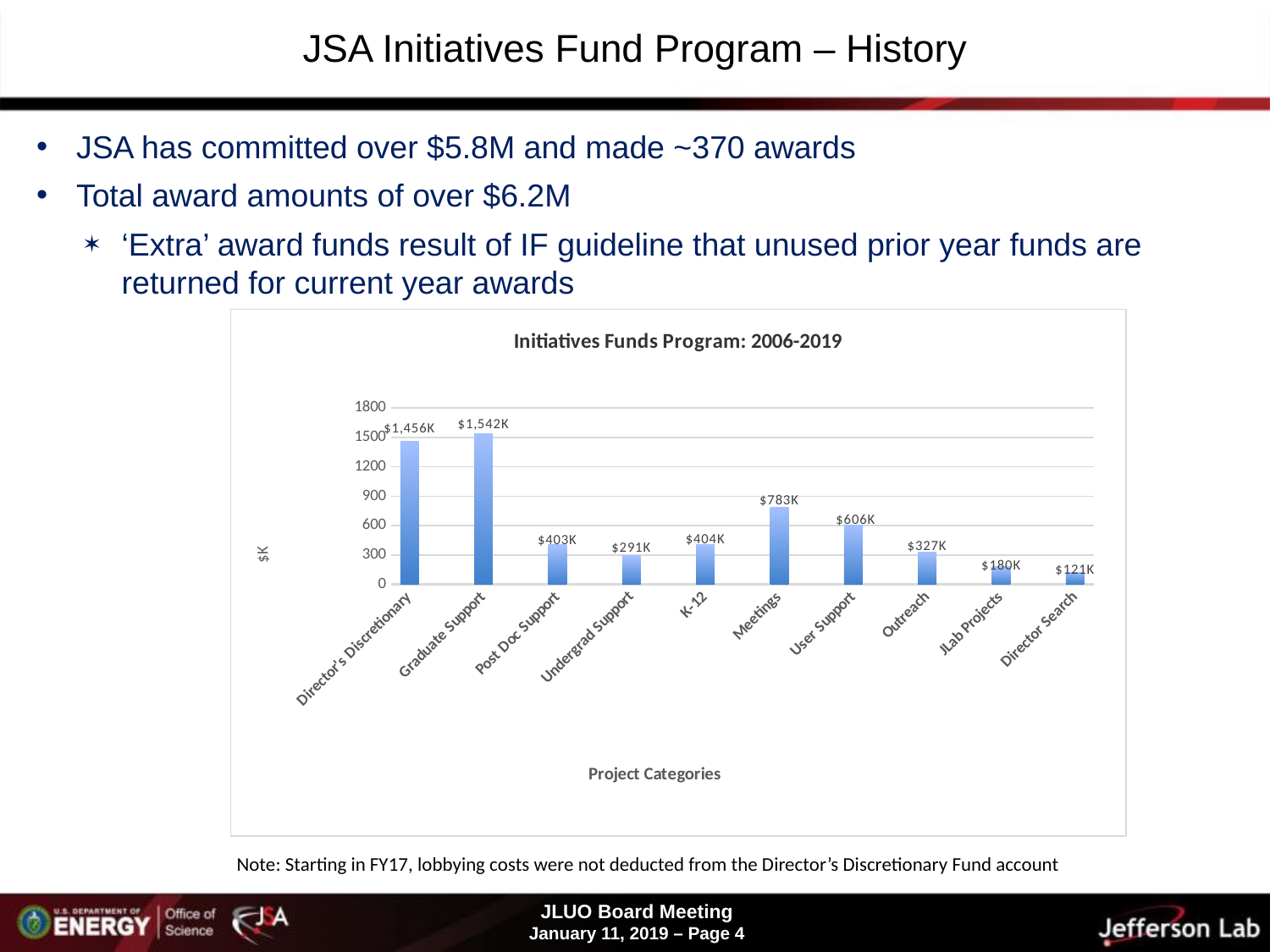
What is the value for Meetings? $783K How many project categories are shown in the chart? 10 What is the title of the chart? Initiatives Funds Program: 2006-2019 What kind of chart is shown on the slide? bar chart What is the label of the vertical axis? $K Which is larger, the value for User Support or the value for Outreach? User Support What is the value for Director Search? $121K Which project category has the lowest value? Director Search What is the value for Graduate Support? $1,542K Which project category has the highest value? Graduate Support What is the difference between the values for Graduate Support and Director's Discretionary? $86K Is the value for Meetings greater or less than 600? greater